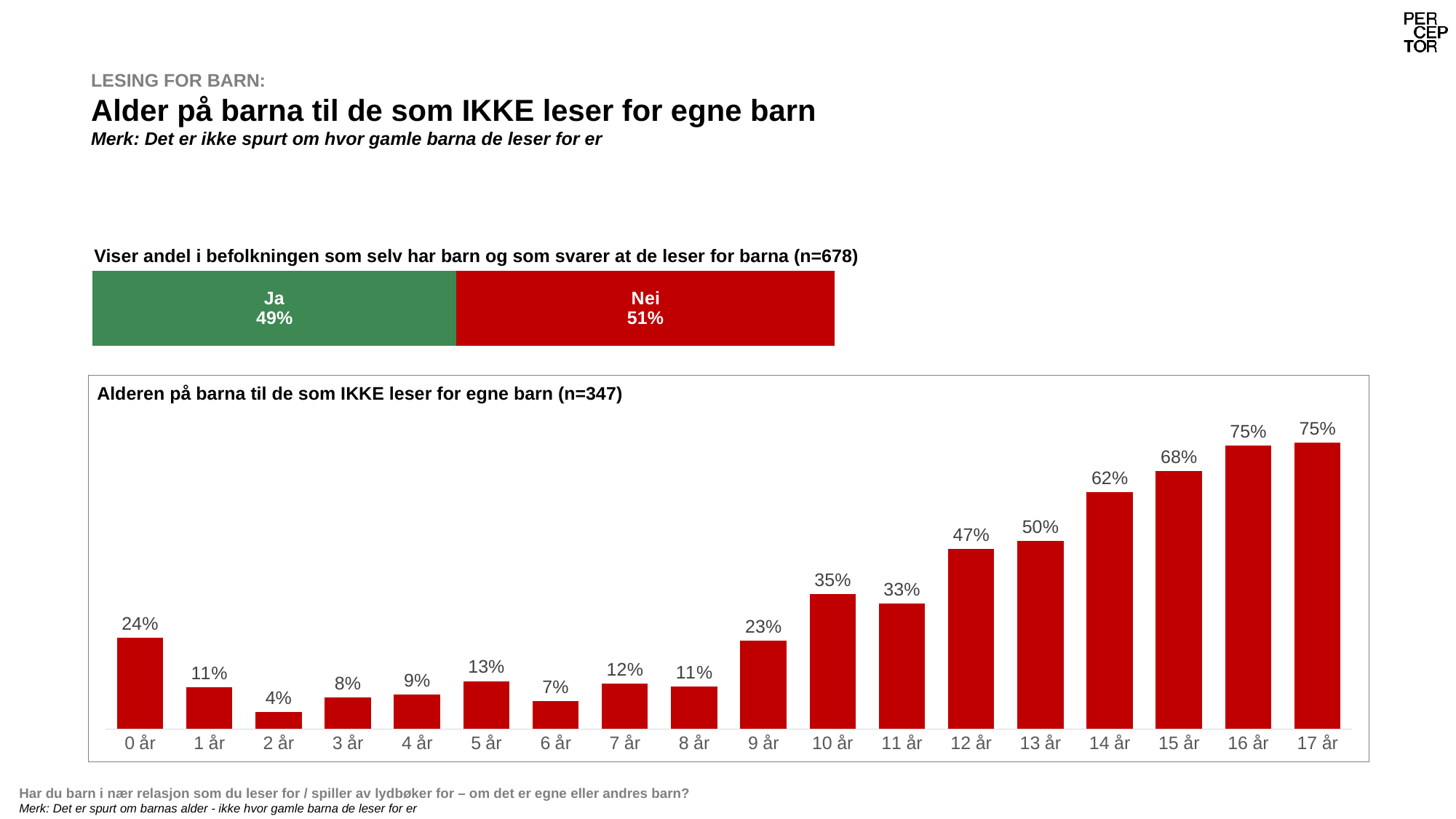
How many age categories are shown in the chart 'Alderen på barna til de som IKKE leser for egne barn (n=347)'? 18 In the chart 'Alderen på barna til de som IKKE leser for egne barn (n=347)', what is the value for 10 år? 35% In the stacked bar 'Viser andel i befolkningen som selv har barn og som svarer at de leser for barna (n=678)', what colour is the Ja segment? Green In the chart 'Alderen på barna til de som IKKE leser for egne barn (n=347)', what is the difference between the values for 15 år and 13 år? 18% In the chart 'Alderen på barna til de som IKKE leser for egne barn (n=347)', what is the value for 0 år? 24% In the chart 'Alderen på barna til de som IKKE leser for egne barn (n=347)', do the values generally rise or fall from 9 år to 17 år? Rise In the stacked bar 'Viser andel i befolkningen som selv har barn og som svarer at de leser for barna (n=678)', what is the total of Ja and Nei? 100% In the stacked bar 'Viser andel i befolkningen som selv har barn og som svarer at de leser for barna (n=678)', what is the value for Nei? 51% In the chart 'Alderen på barna til de som IKKE leser for egne barn (n=347)', which age has the lowest value? 2 år In the chart 'Alderen på barna til de som IKKE leser for egne barn (n=347)', which is larger, the value for 9 år or the value for 11 år? 11 år What kind of chart is 'Alderen på barna til de som IKKE leser for egne barn (n=347)'? Bar chart In the chart 'Alderen på barna til de som IKKE leser for egne barn (n=347)', what is the value for 14 år? 62%